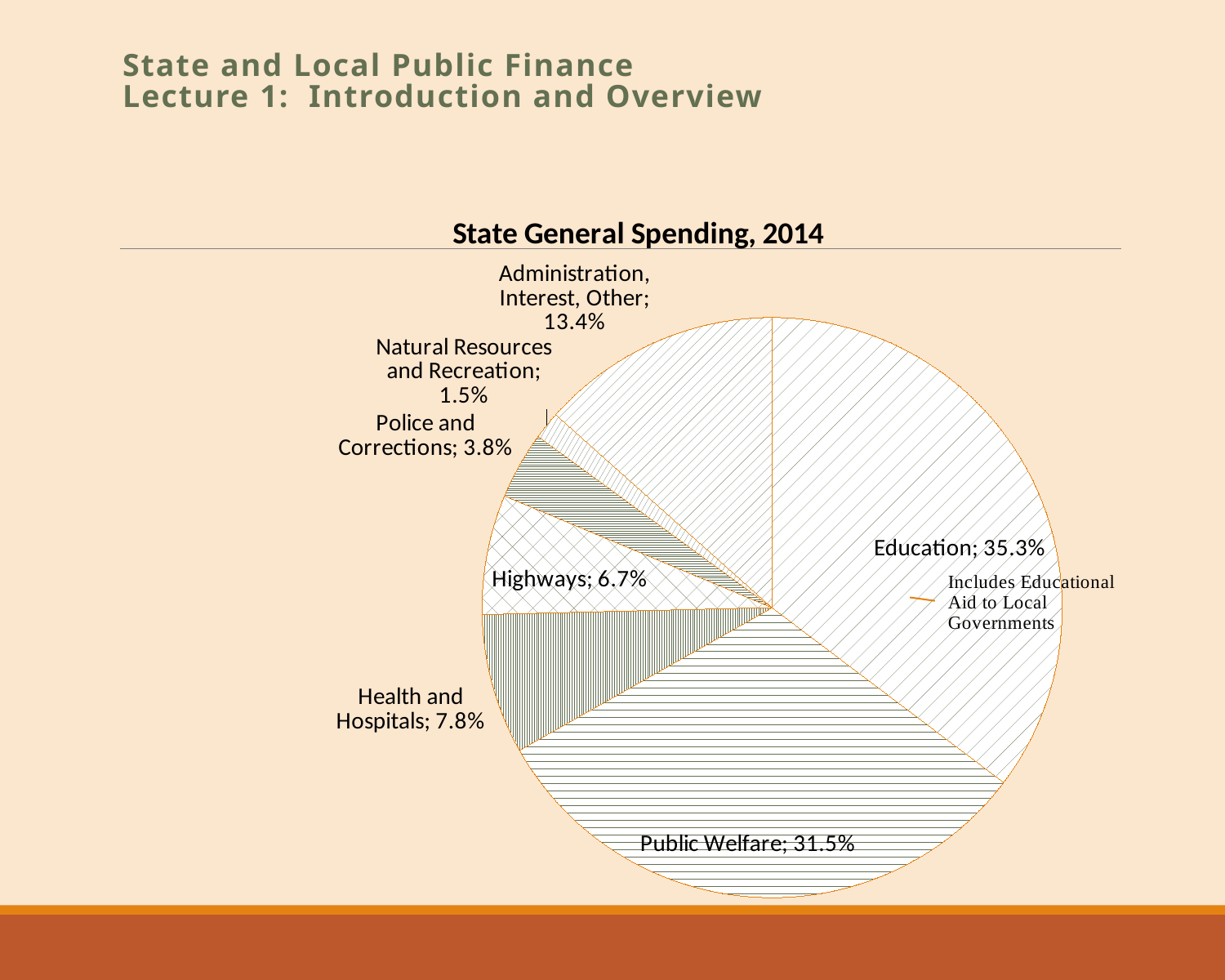
What share of state general spending goes to Education? 35.3% What share of state general spending goes to Health and Hospitals? 7.8% Which category has the smallest share of state general spending? Natural Resources and Recreation What is the title of the chart? State General Spending, 2014 Which is larger, the share for Health and Hospitals or the share for Highways? Health and Hospitals What kind of chart is shown on the slide? pie chart What is the difference in percentage points between Education and Public Welfare? 3.8 What share of state general spending goes to Natural Resources and Recreation? 1.5% What share of state general spending goes to Public Welfare? 31.5% Which category has the largest share of state general spending? Education How many categories are shown in the pie chart? 7 What share of state general spending goes to Highways? 6.7%